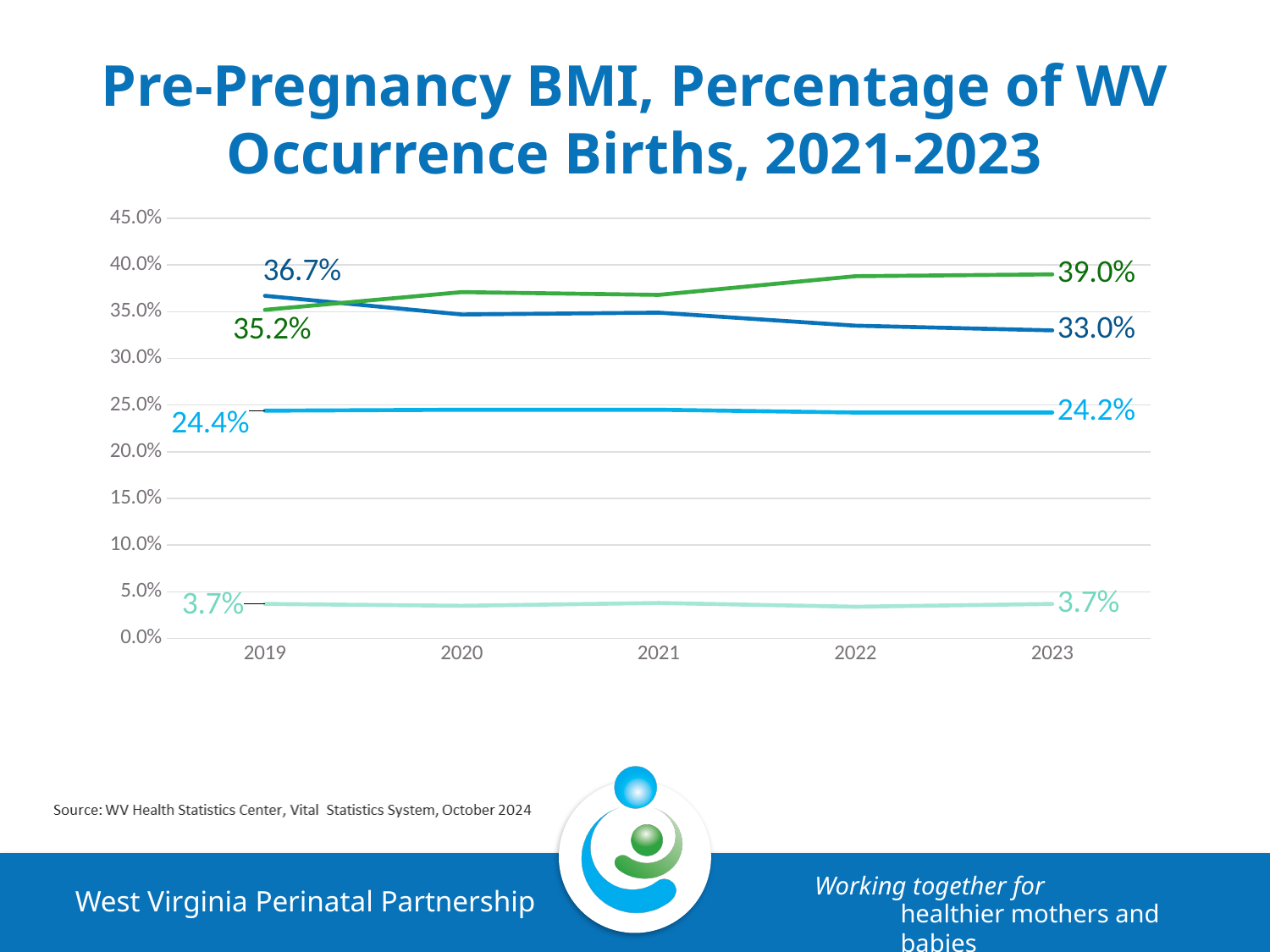
Does the green line rise or fall from 2019 to 2023? rise What is the value of the green line in 2023? 39.0% By how many percentage points did the green line increase from 2019 (35.2%) to 2023 (39.0%)? 3.8% By how many percentage points did the dark blue line decrease from 2019 (36.7%) to 2023 (33.0%)? 3.7% Which line has the highest value in 2023? the green line (39.0%) What is the value of the pale green line in 2019? 3.7% In 2019, which is larger: the dark blue line or the green line? the dark blue line (36.7%) Does the dark blue line rise or fall from 2019 to 2023? fall What is the value of the dark blue line in 2019? 36.7% What kind of chart is shown on the slide? line chart What is the value of the light blue line in 2023? 24.2% How many years are shown on the x axis? 5